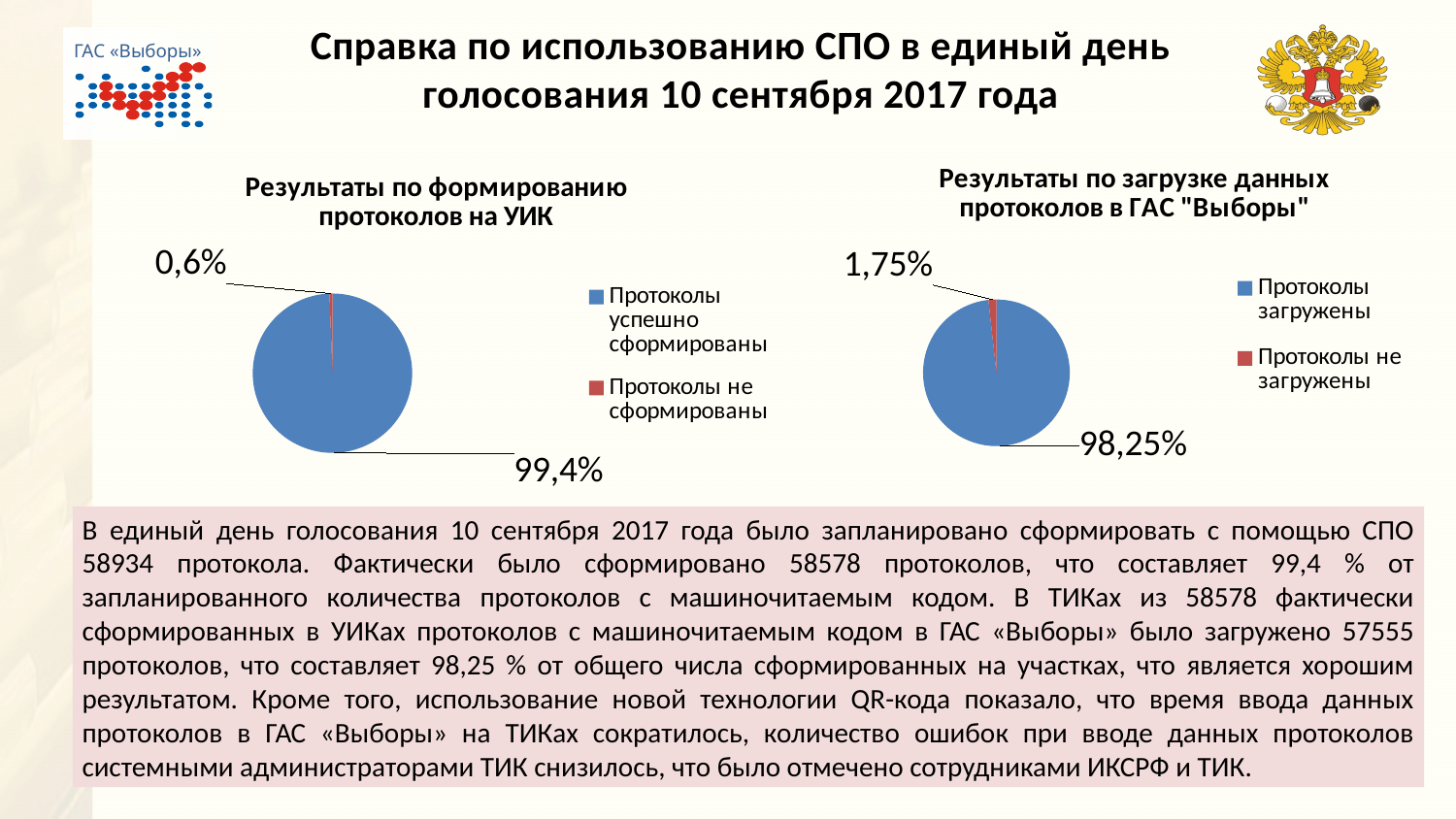
What is the title of the pie chart on the left side of the slide? Результаты по формированию протоколов на УИК In the left chart ("Результаты по формированию протоколов на УИК"), which category has the largest slice? Протоколы успешно сформированы In the chart titled "Результаты по формированию протоколов на УИК", what share is shown for "Протоколы не сформированы"? 0,6% What type of chart is used for "Результаты по формированию протоколов на УИК"? Pie chart Which is larger: the share of "Протоколы не сформированы" in the left chart or the share of "Протоколы не загружены" in the right chart? Протоколы не загружены In the chart "Результаты по загрузке данных протоколов в ГАС "Выборы"", what colour is the slice for "Протоколы не загружены"? Red In the chart titled "Результаты по загрузке данных протоколов в ГАС "Выборы"", what share is shown for "Протоколы загружены"? 98,25% In the right chart ("Результаты по загрузке данных протоколов в ГАС "Выборы""), which category has the smallest slice? Протоколы не загружены In the chart titled "Результаты по загрузке данных протоколов в ГАС "Выборы"", what share is shown for "Протоколы не загружены"? 1,75% How many slices does the pie chart "Результаты по формированию протоколов на УИК" have? 2 How many categories does the legend of the chart "Результаты по загрузке данных протоколов в ГАС "Выборы"" list? 2 In the chart titled "Результаты по формированию протоколов на УИК", what share is shown for "Протоколы успешно сформированы"? 99,4%